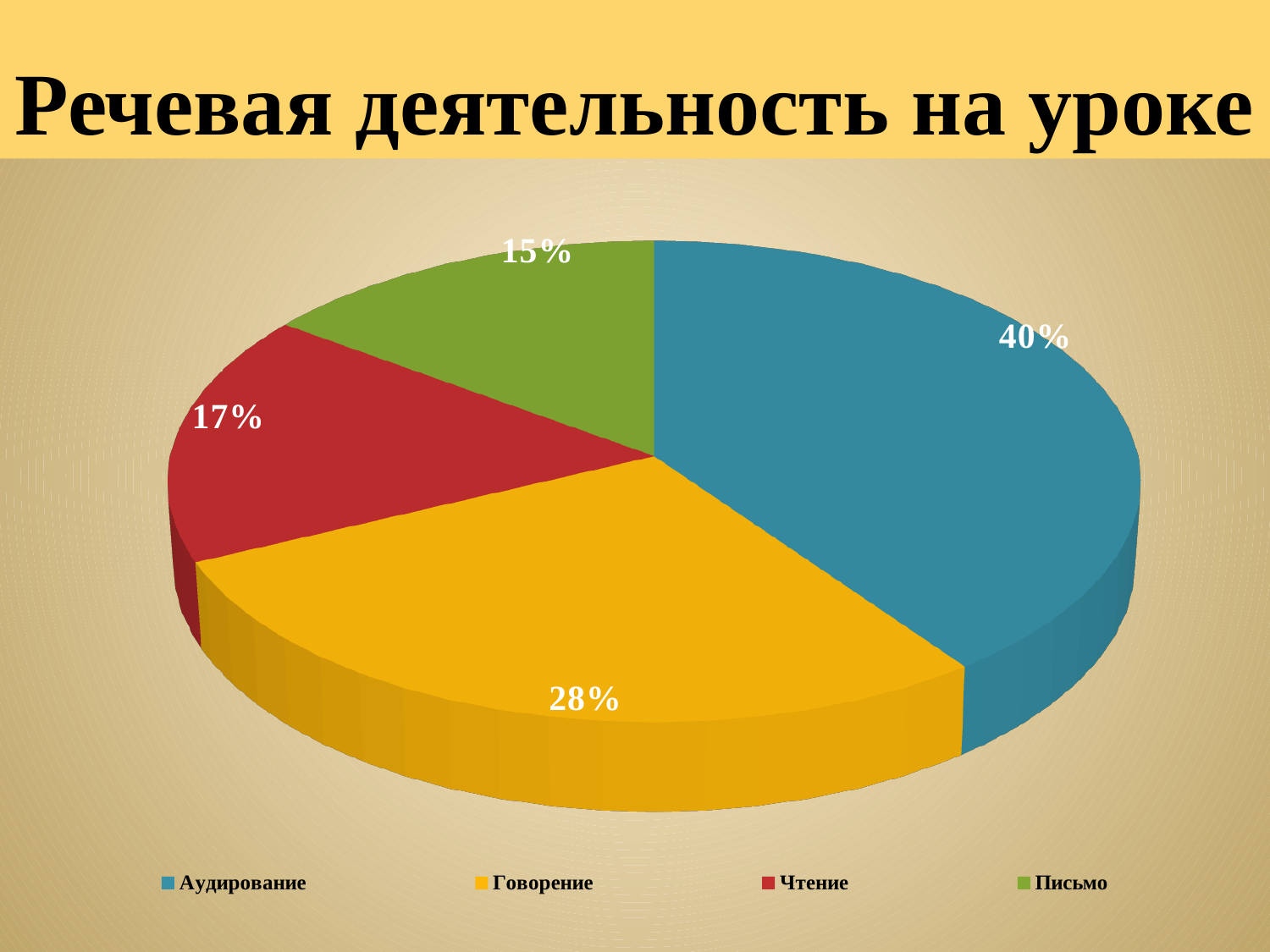
Which category has the largest share of the pie chart? Аудирование What percentage of the pie chart is Письмо? 15% What is the title of the slide? Речевая деятельность на уроке How many categories does the pie chart show? 4 Which category has the smallest share of the pie chart? Письмо What percentage of the pie chart is Говорение? 28% What is the difference in percentage points between Аудирование and Говорение? 12 What colour is the slice for Говорение? Yellow What kind of chart is shown on the slide? Pie chart Which is larger, the share for Чтение or the share for Письмо? Чтение What percentage of the pie chart is Аудирование? 40% What percentage of the pie chart is Чтение? 17%